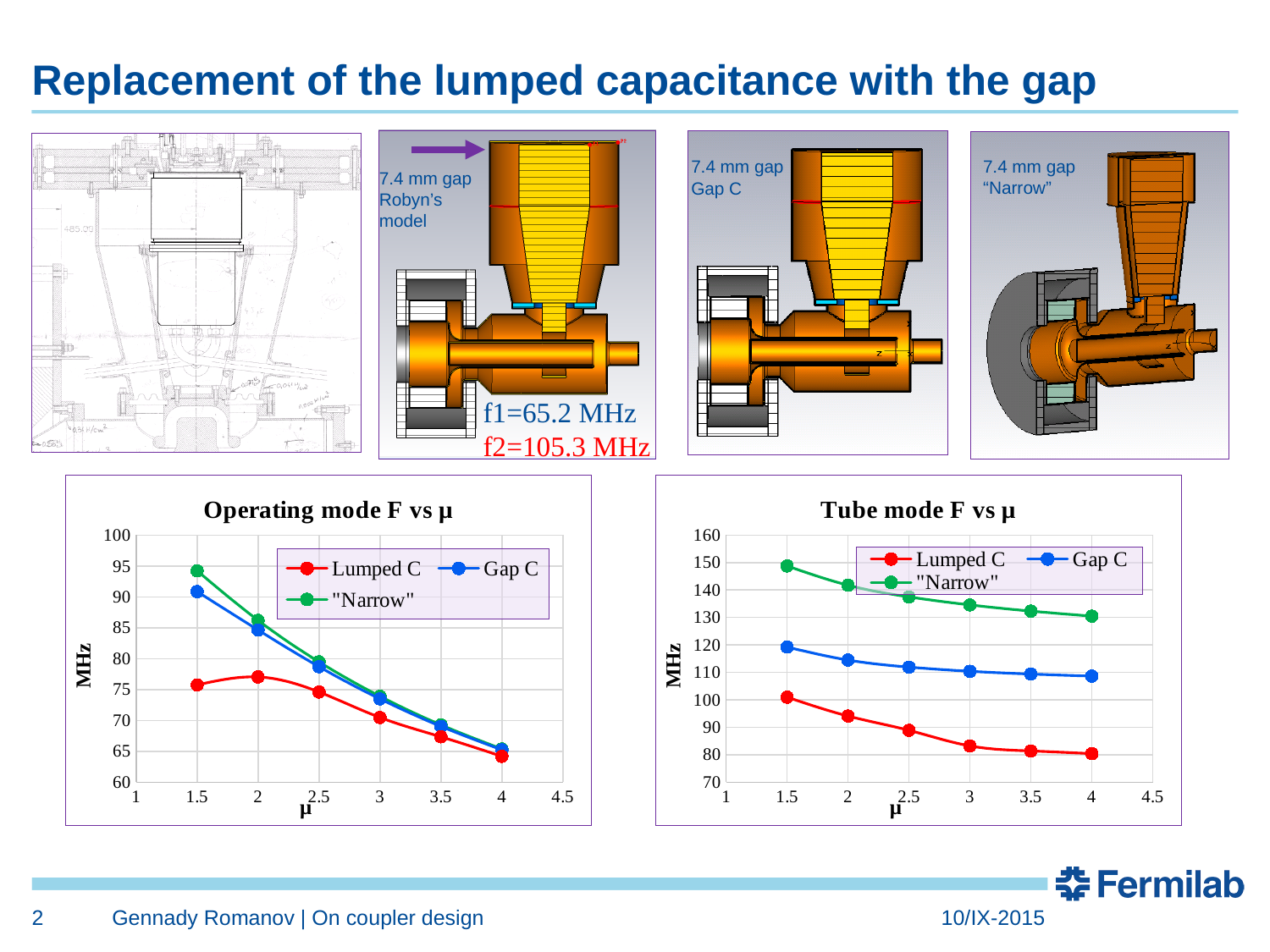
In the "Operating mode F vs μ" chart, how many data points are plotted for the Gap C series? 6 What is the y-axis label of the "Tube mode F vs μ" chart? MHz In the "Tube mode F vs μ" chart, is the value for Lumped C at μ = 4 greater or less than 90? less How many series does the legend of the "Tube mode F vs μ" chart list? 3 In the "Tube mode F vs μ" chart, which series has the highest value at μ = 3? "Narrow" What kind of chart is the "Operating mode F vs μ" chart? line chart In the "Tube mode F vs μ" chart, does the Lumped C series rise or fall as μ increases? fall In the "Tube mode F vs μ" chart, is the value for "Narrow" at μ = 1.5 greater or less than 140? greater In the "Tube mode F vs μ" chart, which is larger at μ = 1.5: "Narrow" or Lumped C? "Narrow" In the "Operating mode F vs μ" chart, which series has the lowest value at μ = 1.5? Lumped C In the "Operating mode F vs μ" chart, does the Gap C series rise or fall as μ increases? fall In the "Operating mode F vs μ" chart, is the value for "Narrow" at μ = 1.5 greater or less than 90? greater